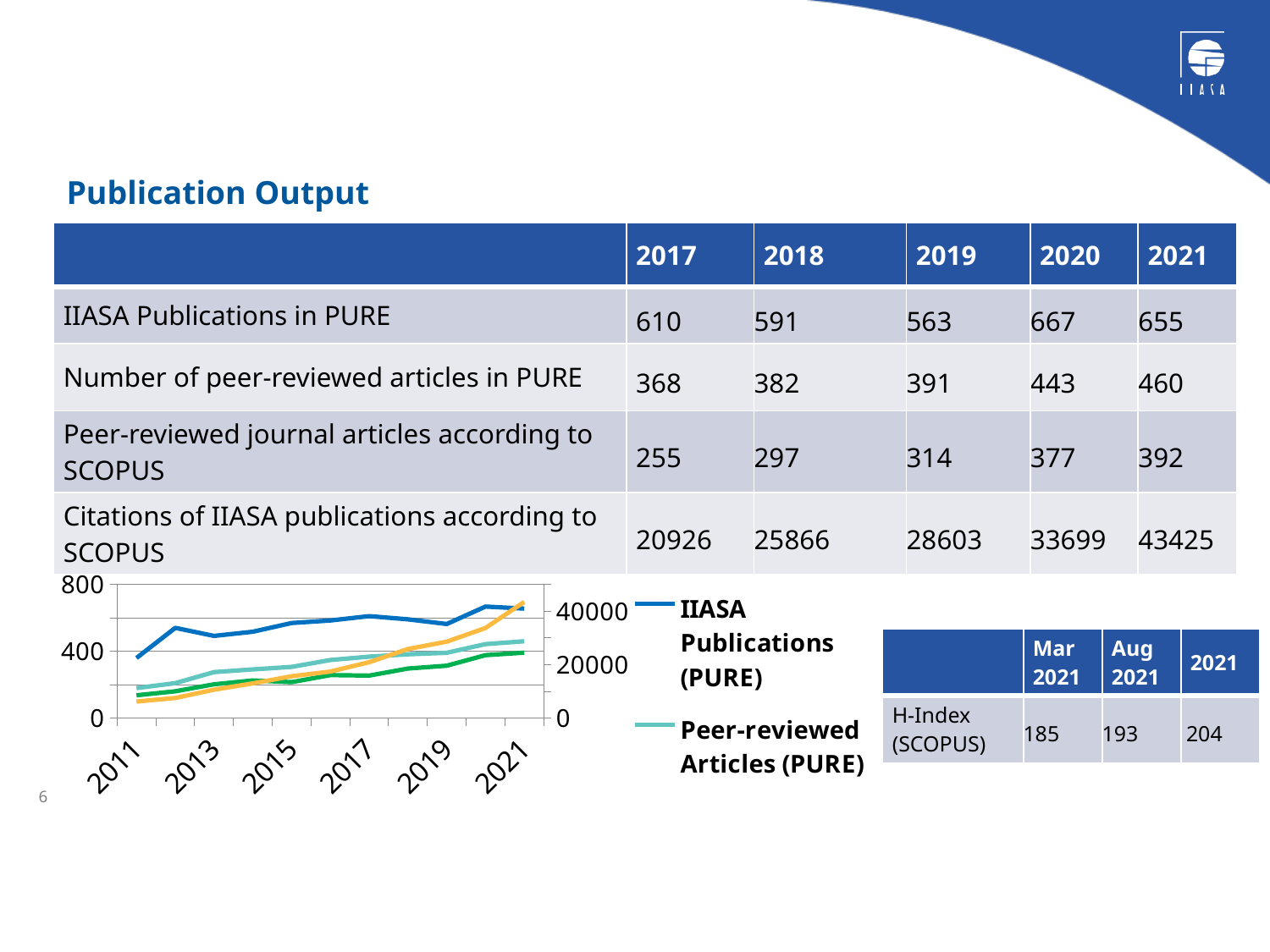
In the line chart, what is the first year shown on the x axis? 2011 In the line chart, is the value for IIASA Publications (PURE) in 2021 greater or less than 400? greater In the line chart, what is the last year shown on the x axis? 2021 What is the highest tick value on the left vertical axis of the line chart? 800 In the line chart, does the Peer-reviewed Articles (PURE) line rise or fall overall from 2011 to 2021? rise How many lines are plotted in the line chart? 4 In the line chart, is the value for Peer-reviewed Articles (PURE) in 2011 greater or less than 400? less How many year labels are shown on the x axis of the line chart? 6 In the line chart, does the IIASA Publications (PURE) line rise or fall overall from 2011 to 2021? rise In the line chart, which is higher in 2021: IIASA Publications (PURE) or Peer-reviewed Articles (PURE)? IIASA Publications (PURE) What kind of chart is shown at the bottom left of the slide? line chart